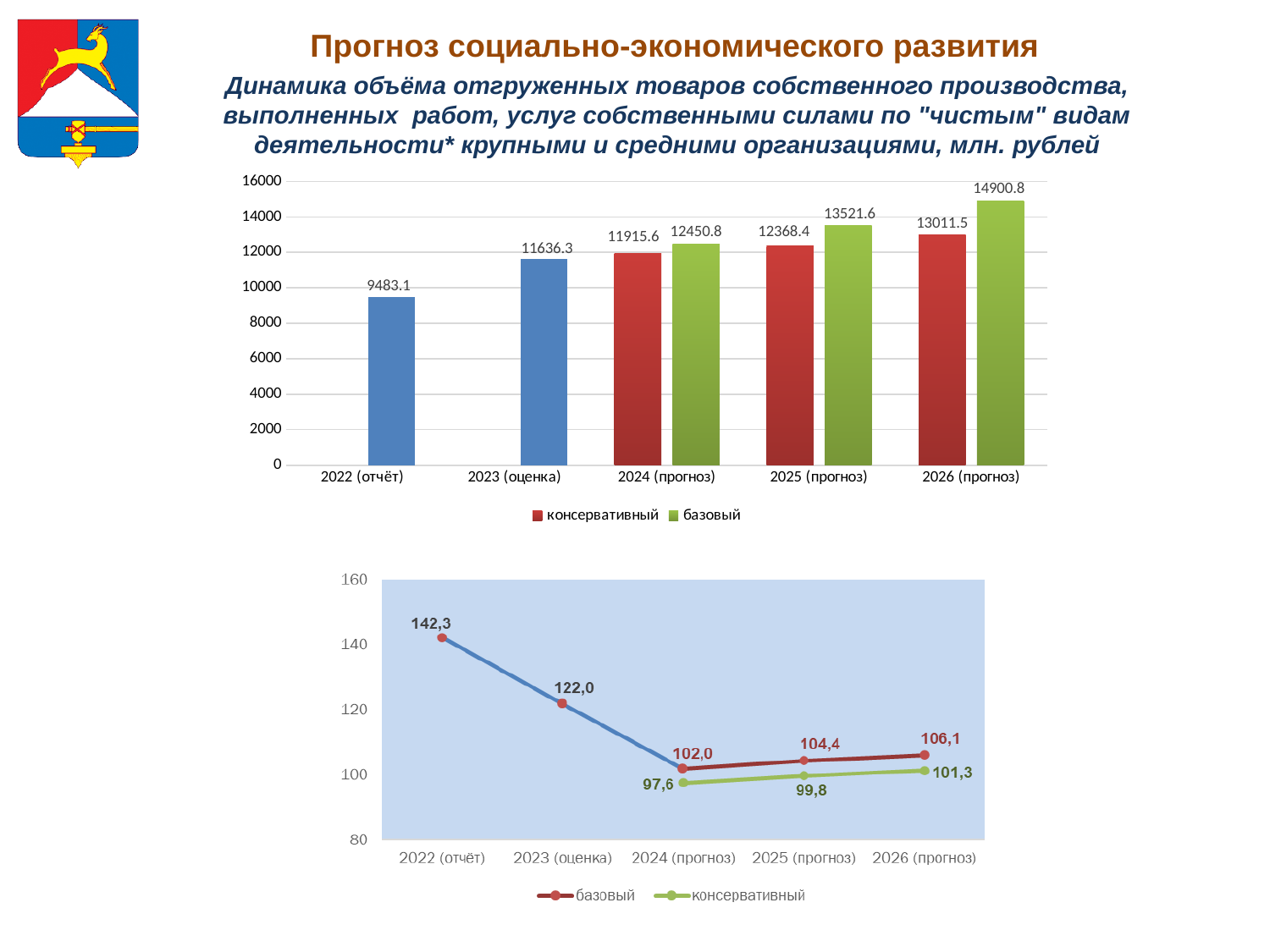
In the top bar chart, which category has the lowest bar? 2022 (отчёт) In the bottom line chart, what is the консервативный value for 2025 (прогноз)? 99,8 In the top bar chart, what is the value for 2022 (отчёт)? 9483.1 In the top bar chart, how many series does the legend list? 2 In the bottom line chart, which is larger for 2026 (прогноз): базовый or консервативный? базовый In the bottom line chart, how many categories are shown on the x axis? 5 In the top bar chart, what is the базовый value for 2026 (прогноз)? 14900.8 In the top bar chart, what is the difference between the базовый and консервативный values for 2024 (прогноз)? 535.2 In the bottom line chart, what is the difference between the базовый values for 2026 (прогноз) and 2024 (прогноз)? 4,1 What kind of chart is the top chart on the slide? bar chart In the top bar chart, what is the консервативный value for 2025 (прогноз)? 12368.4 In the bottom line chart, what is the value for 2022 (отчёт)? 142,3